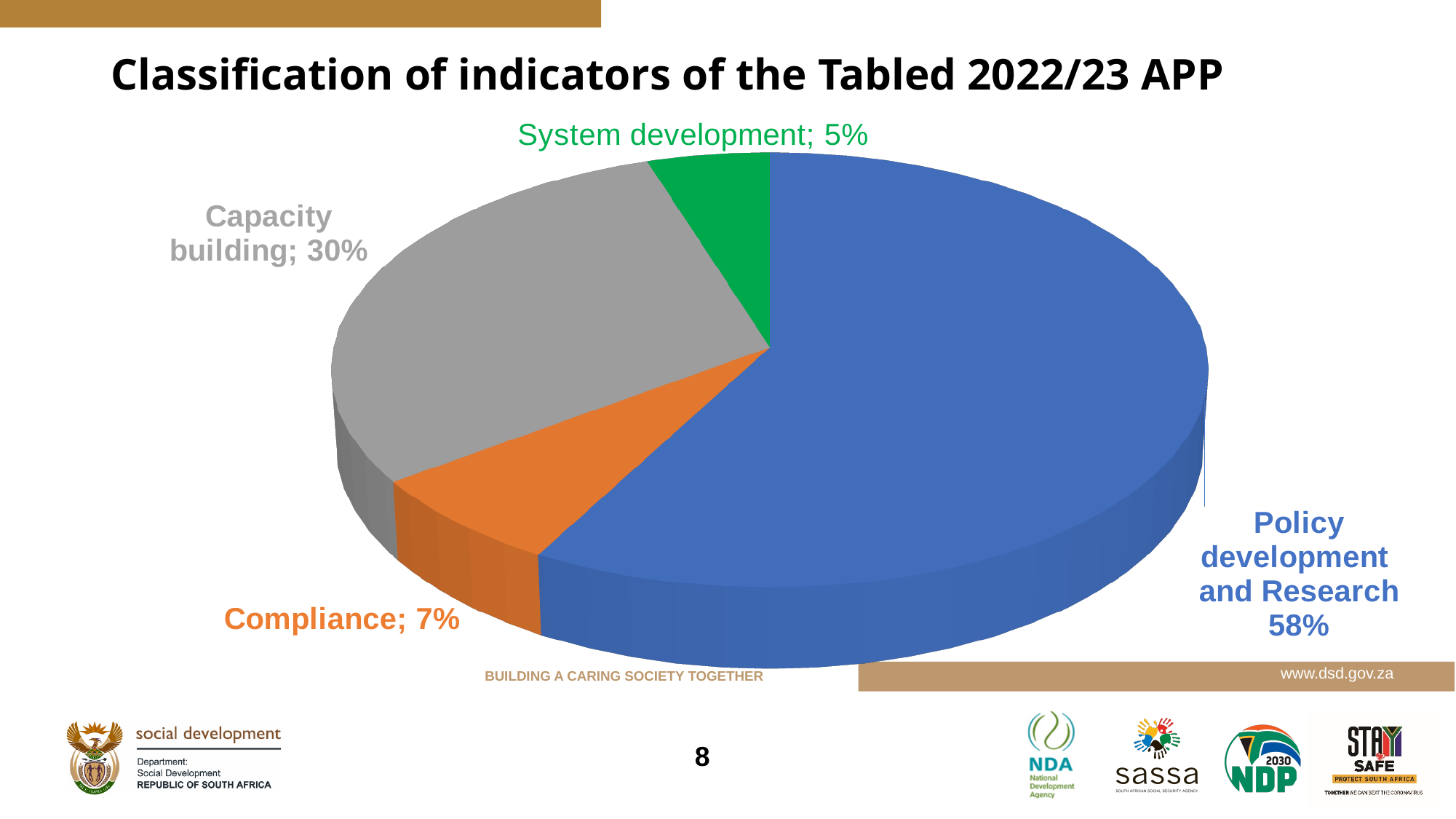
Which is larger, the share for Compliance or the share for System development? Compliance What share of indicators is classified as Policy development and Research? 58% How many categories are shown in the pie chart? 4 What is the difference in percentage points between Policy development and Research and Capacity building? 28 What share of indicators is classified as Capacity building? 30% What kind of chart is shown on the slide? pie chart What share of indicators is classified as System development? 5% Which category has the largest share of the pie? Policy development and Research What is the title of the chart on the slide? Classification of indicators of the Tabled 2022/23 APP What is the combined share of Compliance and System development? 12% What share of indicators is classified as Compliance? 7% Which category has the smallest share of the pie? System development